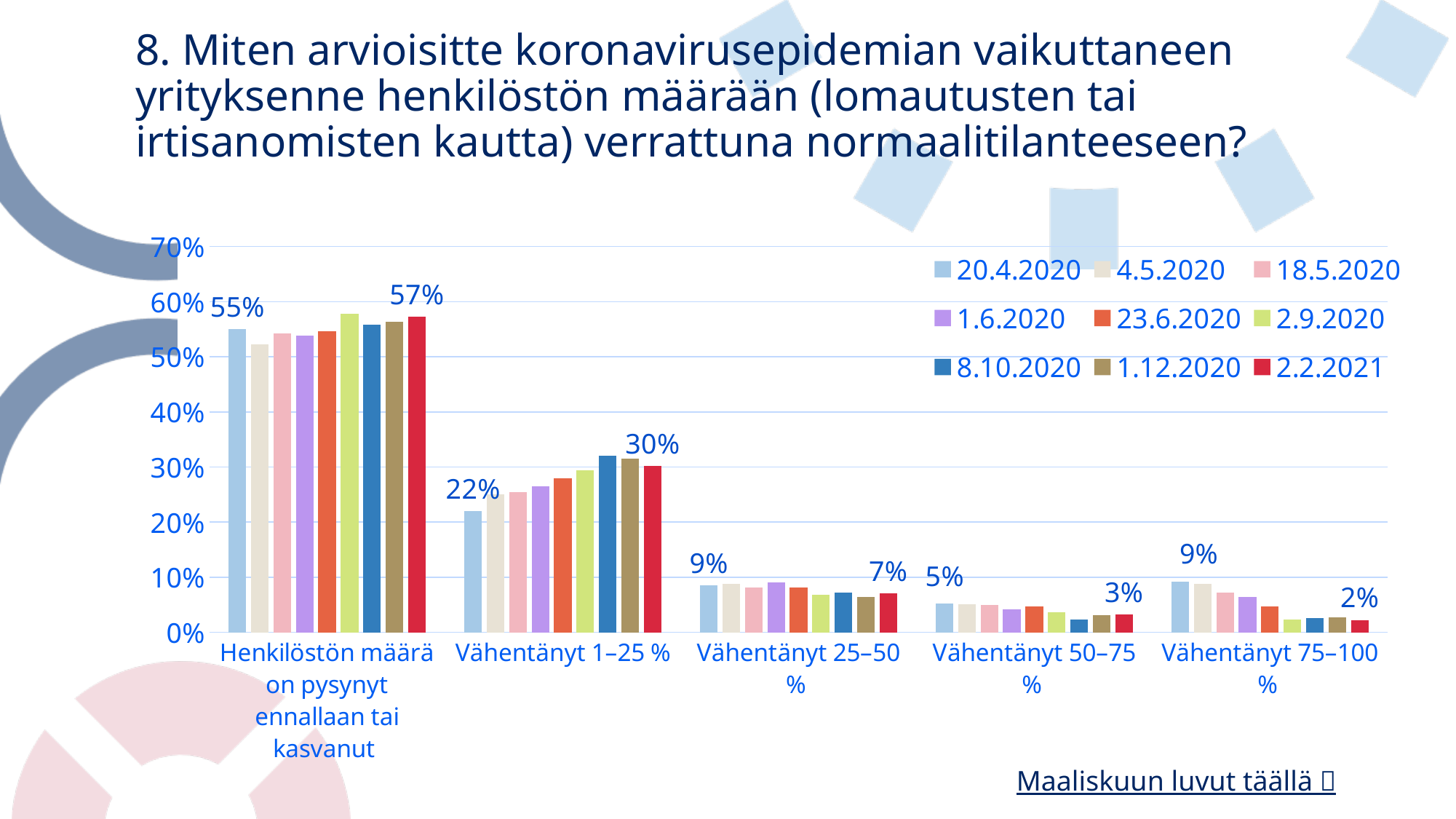
How many series does the legend list? 9 Is the value for 'Vähentänyt 1–25 %' in the 8.10.2020 series greater or less than 30%? greater What is the value for 'Vähentänyt 1–25 %' in the 2.2.2021 series? 30% What is the difference between the 2.2.2021 and 20.4.2020 values for 'Vähentänyt 1–25 %'? 8% Which legend entry is shown in red? 2.2.2021 Which category has the highest value in the 2.2.2021 series? Henkilöstön määrä on pysynyt ennallaan tai kasvanut Which is larger for 'Vähentänyt 50–75 %': the 20.4.2020 value or the 2.2.2021 value? 20.4.2020 What is the value for 'Henkilöstön määrä on pysynyt ennallaan tai kasvanut' in the 2.2.2021 series? 57% How many categories are shown on the x axis? 5 What is the value for 'Vähentänyt 75–100 %' in the 20.4.2020 series? 9% What kind of chart is shown on the slide? bar chart What is the value for 'Henkilöstön määrä on pysynyt ennallaan tai kasvanut' in the 20.4.2020 series? 55%